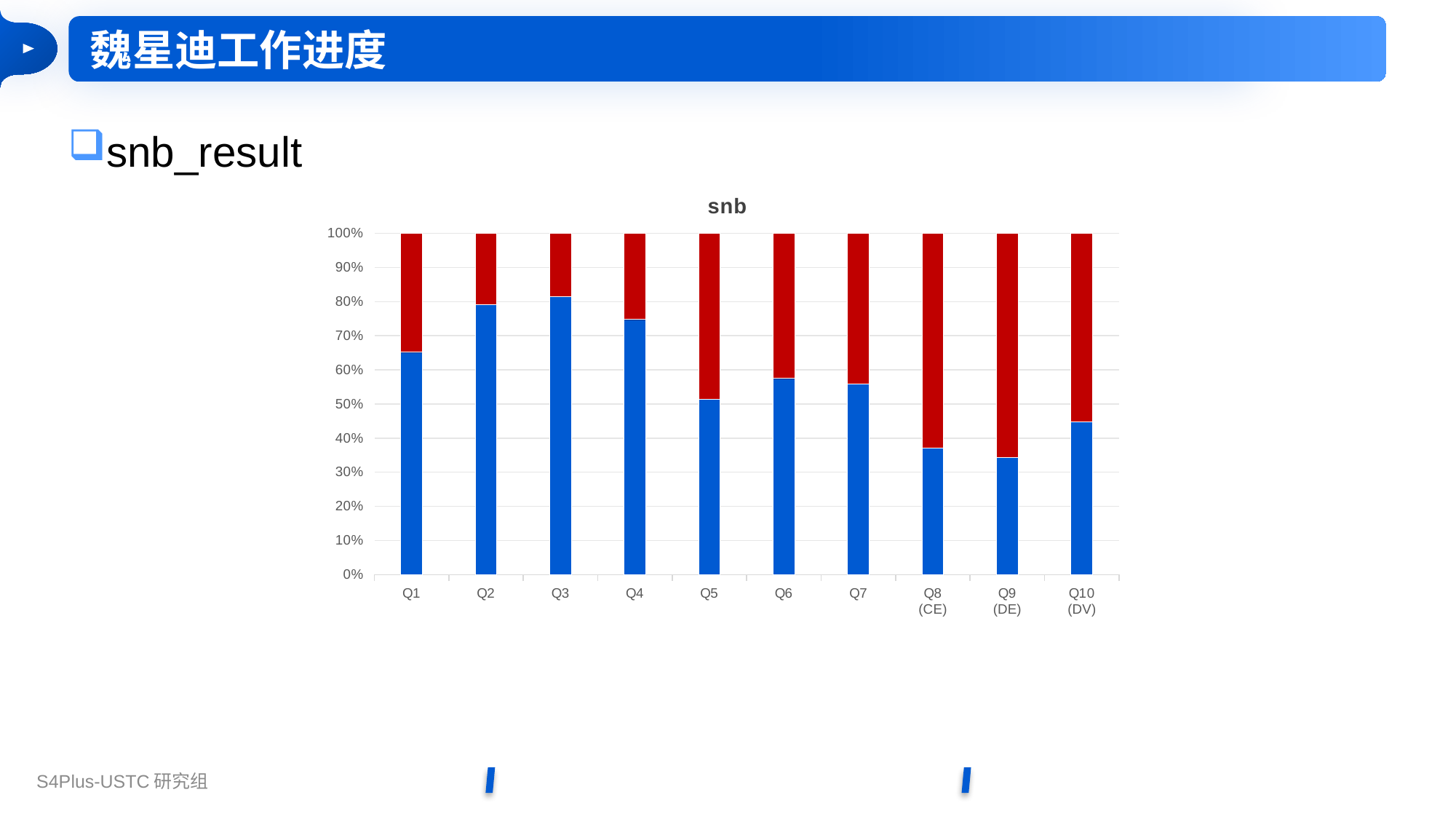
What is the title of the chart? snb Which has the larger red segment, Q1 or Q8 (CE)? Q8 (CE) Is the blue segment for Q1 greater or less than 60%? greater Is the blue segment for Q8 (CE) greater or less than 40%? less Is the blue segment for Q2 greater or less than 70%? greater Which has the larger blue segment, Q3 or Q9 (DE)? Q3 What kind of chart is shown on the slide? stacked bar chart How many categories are shown on the x axis of the chart? 10 What is the total height of the stacked bar for Q1? 100% What colours are the two segments of each stacked bar? blue and red